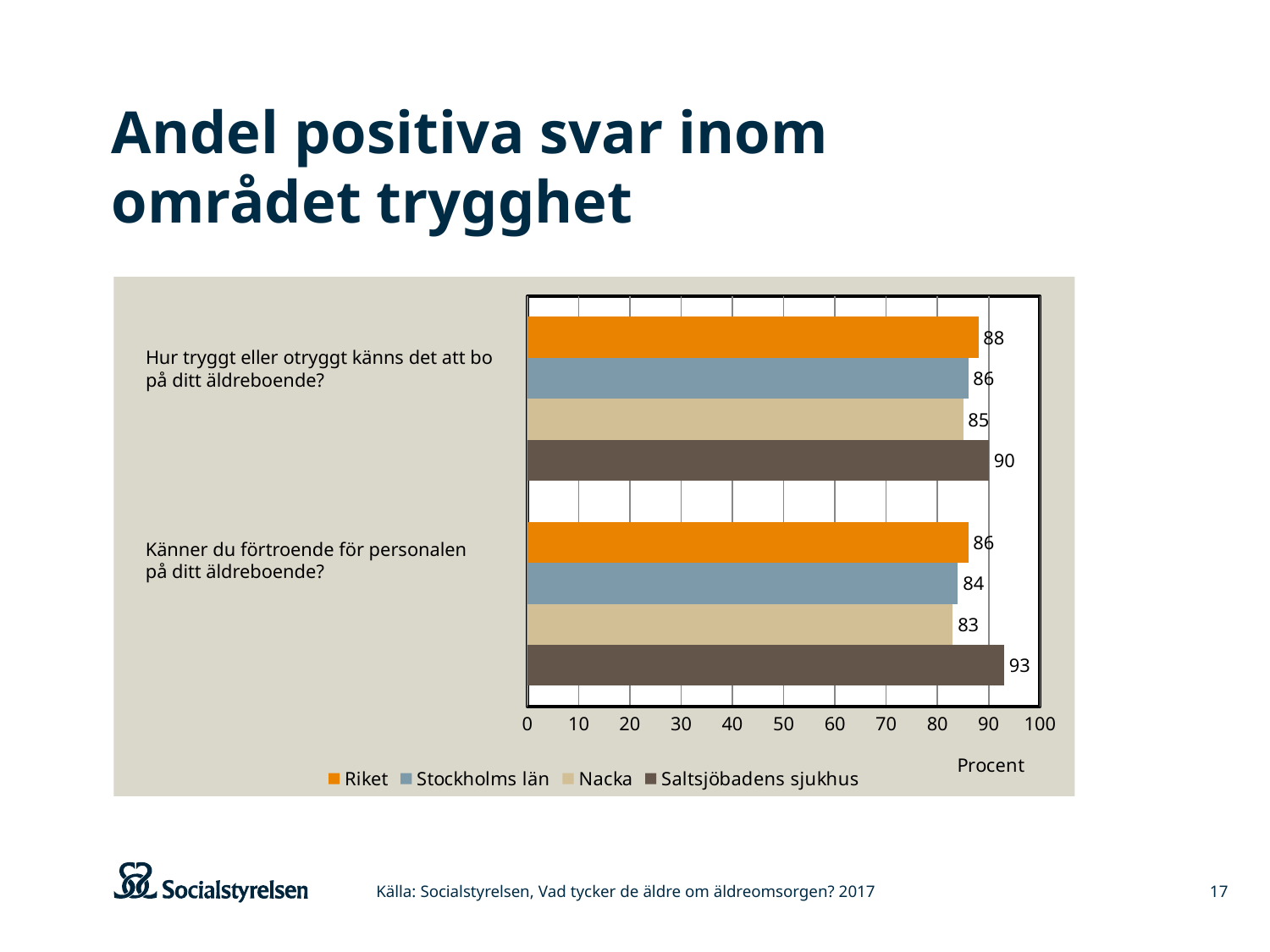
What unit label is shown on the x axis of the chart? Procent Which series has the lowest value for the question "Hur tryggt eller otryggt känns det att bo på ditt äldreboende?"? Nacka What is the difference between the Saltsjöbadens sjukhus value and the Nacka value for the question "Känner du förtroende för personalen på ditt äldreboende?"? 10 Which series has the highest value for the question "Känner du förtroende för personalen på ditt äldreboende?"? Saltsjöbadens sjukhus What value is shown for Stockholms län on the question "Hur tryggt eller otryggt känns det att bo på ditt äldreboende?"? 86 What value is shown for Riket on the question "Hur tryggt eller otryggt känns det att bo på ditt äldreboende?"? 88 Which is larger: the Riket value or the Saltsjöbadens sjukhus value for the question "Hur tryggt eller otryggt känns det att bo på ditt äldreboende?"? Saltsjöbadens sjukhus What kind of chart is shown on the slide? Bar chart How many series does the legend list? 4 What value is shown for Nacka on the question "Känner du förtroende för personalen på ditt äldreboende?"? 83 What is the difference between the Riket value and the Stockholms län value for the question "Hur tryggt eller otryggt känns det att bo på ditt äldreboende?"? 2 What value is shown for Saltsjöbadens sjukhus on the question "Känner du förtroende för personalen på ditt äldreboende?"? 93